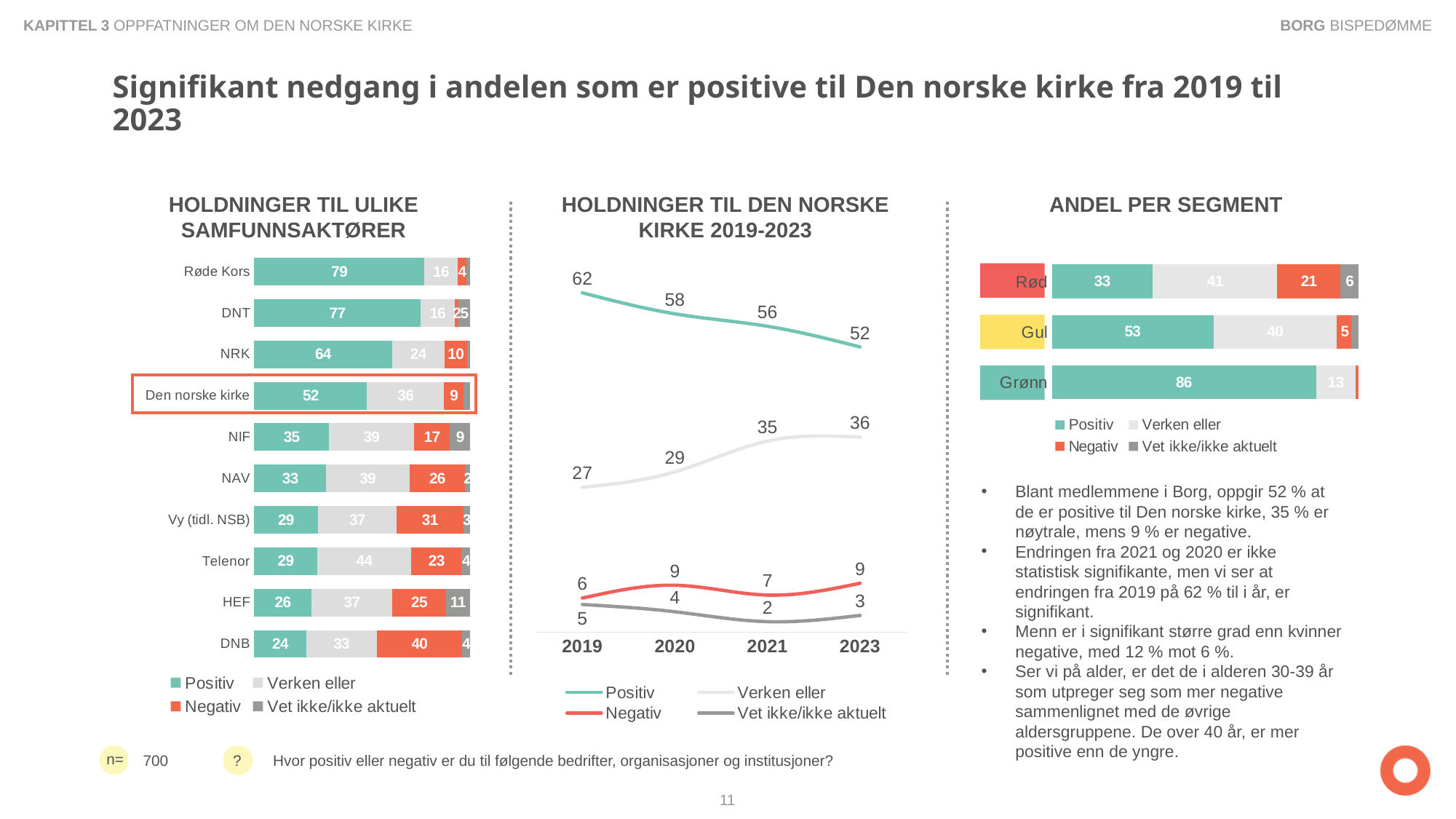
In the chart 'ANDEL PER SEGMENT', which segment has the lowest Positiv value? Rød In the chart 'HOLDNINGER TIL ULIKE SAMFUNNSAKTØRER', what is the difference between the Positiv values for Den norske kirke and NIF? 17 How many series does the legend of the chart 'HOLDNINGER TIL DEN NORSKE KIRKE 2019-2023' list? 4 In the chart 'HOLDNINGER TIL ULIKE SAMFUNNSAKTØRER', which category has the highest Positiv value? Røde Kors In the chart 'HOLDNINGER TIL ULIKE SAMFUNNSAKTØRER', what is the Positiv value for NRK? 64 What type of chart is 'HOLDNINGER TIL DEN NORSKE KIRKE 2019-2023'? Line chart How many categories are shown in the chart 'HOLDNINGER TIL ULIKE SAMFUNNSAKTØRER'? 10 In the chart 'HOLDNINGER TIL DEN NORSKE KIRKE 2019-2023', what is the Positiv value for 2020? 58 In the chart 'HOLDNINGER TIL DEN NORSKE KIRKE 2019-2023', does the Positiv series rise or fall from 2019 to 2023? Fall In the chart 'HOLDNINGER TIL DEN NORSKE KIRKE 2019-2023', what is the difference between the Verken eller values for 2023 and 2019? 9 In the chart 'ANDEL PER SEGMENT', what is the Positiv value for Gul? 53 In the chart 'HOLDNINGER TIL ULIKE SAMFUNNSAKTØRER', which category has the highest Negativ value? DNB